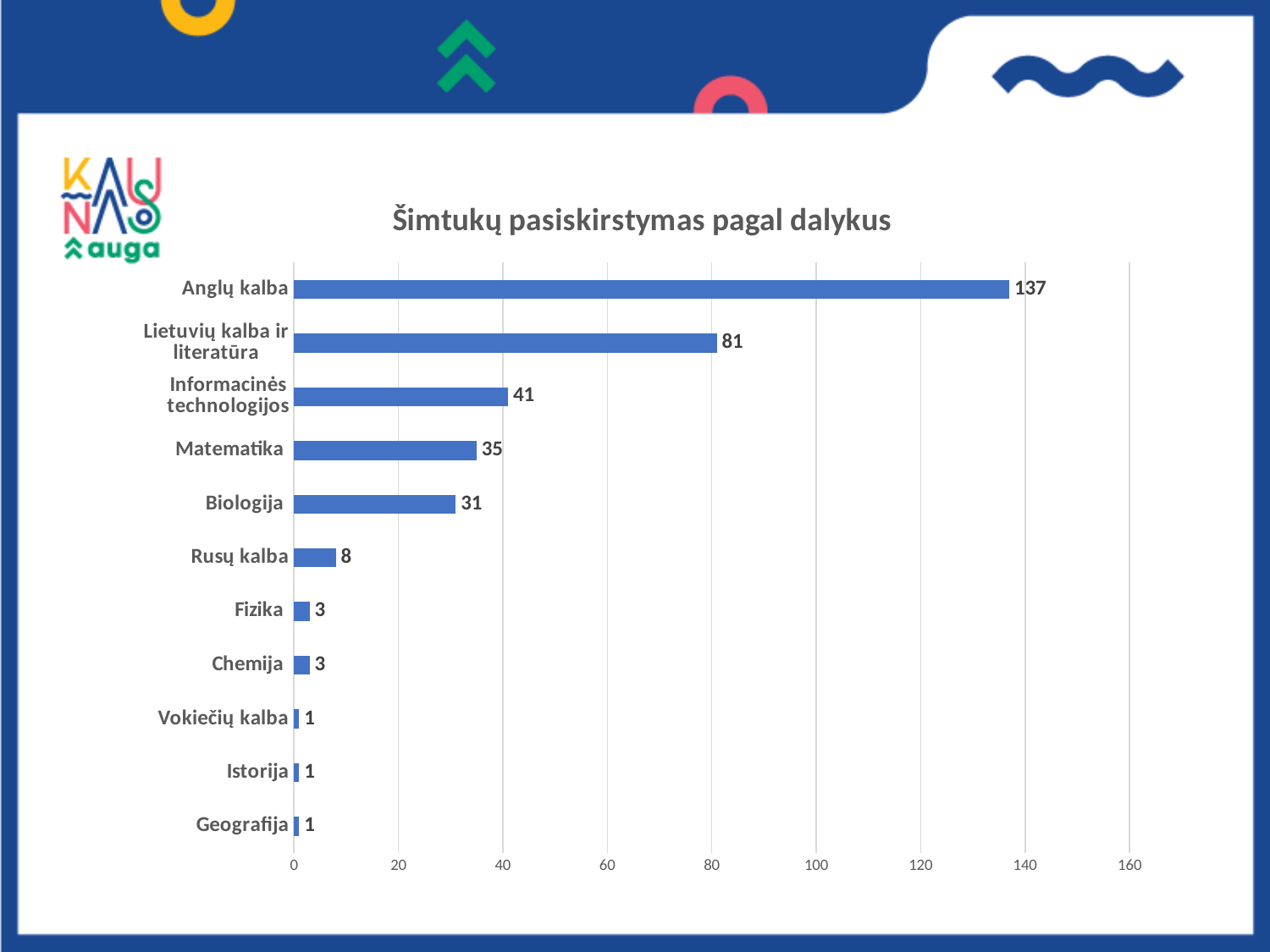
What is the value for Biologija? 31 What is the value for Lietuvių kalba ir literatūra? 81 Which is larger, the value for Matematika or the value for Biologija? Matematika What kind of chart is shown on the slide? bar chart What is the title of the chart? Šimtukų pasiskirstymas pagal dalykus Which category has the highest value? Anglų kalba What is the difference between the values for Informacinės technologijos and Matematika? 6 What is the value for Anglų kalba? 137 What is the value for Rusų kalba? 8 Is the value for Anglų kalba greater or less than 120? greater What is the difference between the values for Anglų kalba and Lietuvių kalba ir literatūra? 56 How many categories are shown in the chart? 11